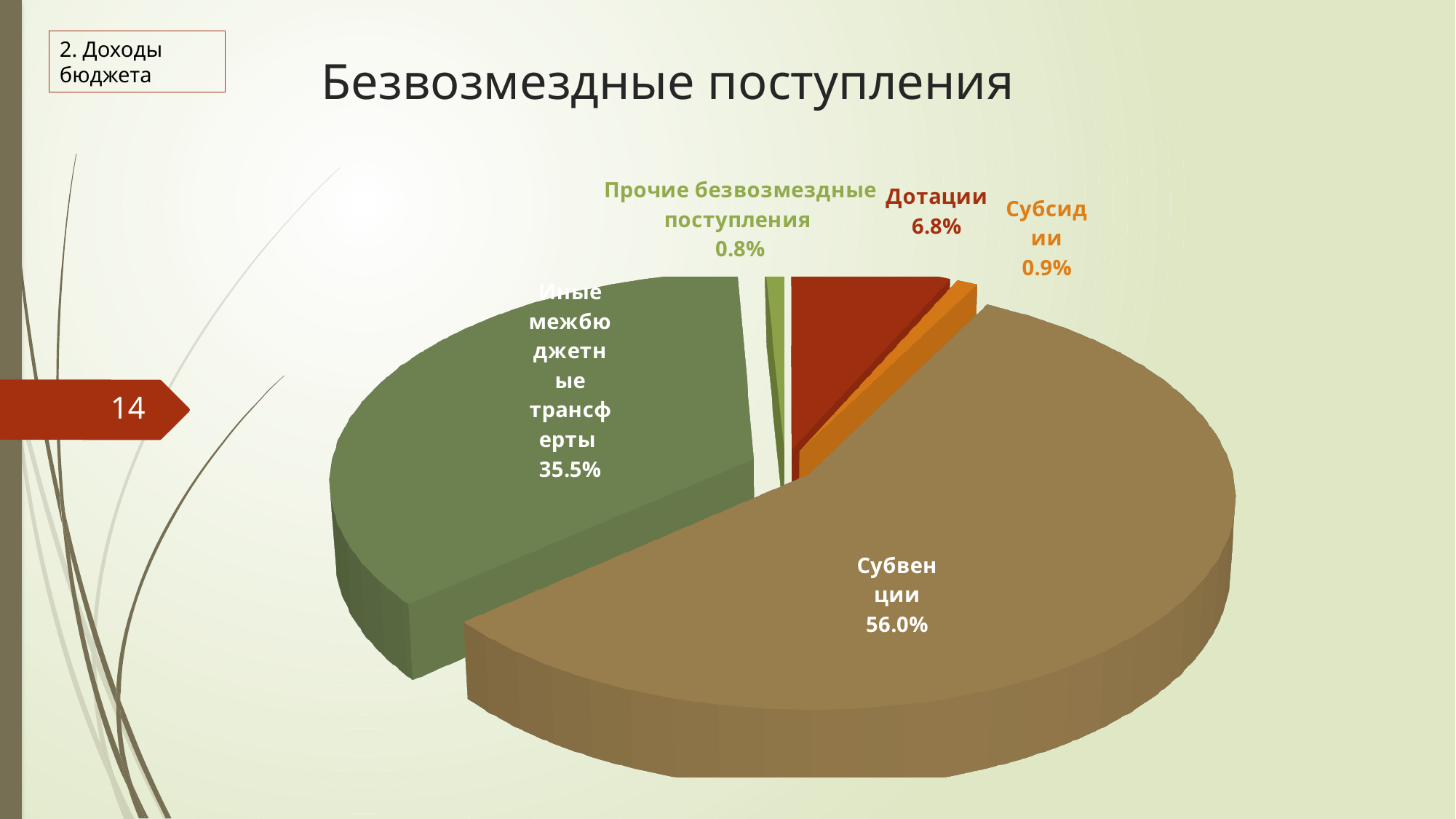
What type of chart is shown on the slide? Pie chart Which category has the smallest share of the pie? Прочие безвозмездные поступления What is the value shown for Субсидии? 0.9% Which category has the largest share of the pie? Субвенции How many slices does the pie chart have? 5 What is the difference in percentage points between Субвенции and Иные межбюджетные трансферты? 20.5 What is the value shown for Дотации? 6.8% What share of the pie does Иные межбюджетные трансферты hold? 35.5% What is the title of the chart? Безвозмездные поступления What share of the pie does Субвенции hold? 56.0% Which is larger, the share for Дотации or the share for Субсидии? Дотации What is the value shown for Прочие безвозмездные поступления? 0.8%